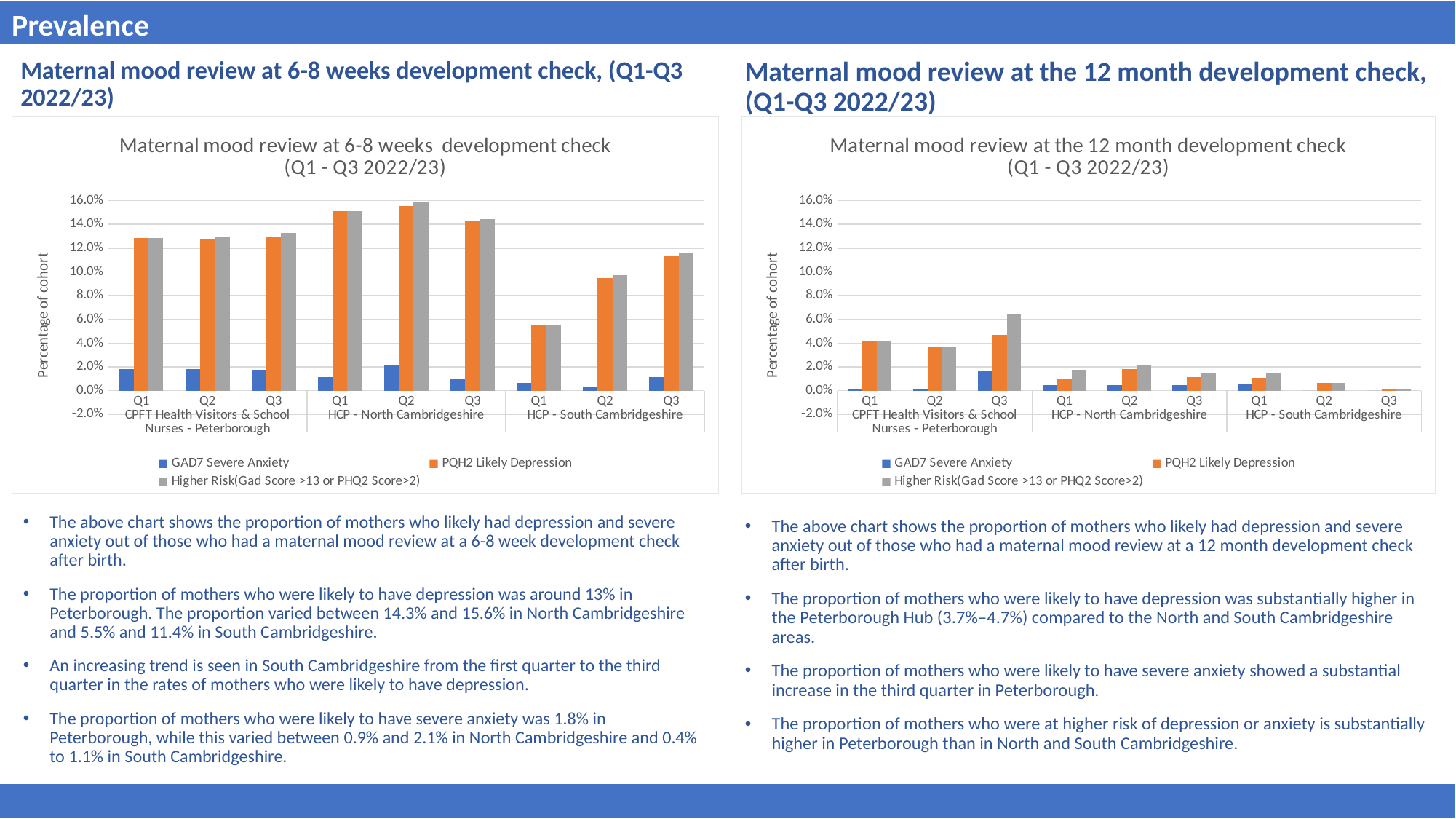
What type of chart is the left chart, 'Maternal mood review at 6-8 weeks development check'? bar chart In the left chart (6-8 weeks), is the PQH2 Likely Depression value for Q1 in CPFT Health Visitors & School Nurses - Peterborough greater or less than 12.0%? greater What is the y-axis label of the right chart (12 month check)? Percentage of cohort In the right chart (12 month check), is the Higher Risk value for Q3 in CPFT Health Visitors & School Nurses - Peterborough greater or less than 4.0%? greater In the left chart (6-8 weeks), which quarter and area has the highest PQH2 Likely Depression value? Q2, HCP - North Cambridgeshire In the left chart (6-8 weeks), does the PQH2 Likely Depression value for HCP - South Cambridgeshire rise or fall from Q1 to Q3? rise How many quarter categories are plotted along the x axis of the right chart (12 month check)? 9 How many series does the legend of the left chart (6-8 weeks) list? 3 In the right chart (12 month check), which is larger: the PQH2 Likely Depression value for Q1 in CPFT Health Visitors & School Nurses - Peterborough or for Q1 in HCP - North Cambridgeshire? Q1 in CPFT Health Visitors & School Nurses - Peterborough In the right chart (12 month check), which quarter and area has the highest Higher Risk value? Q3, CPFT Health Visitors & School Nurses - Peterborough In the left chart (6-8 weeks), which quarter and area has the lowest PQH2 Likely Depression value? Q1, HCP - South Cambridgeshire In the left chart (6-8 weeks), is the PQH2 Likely Depression value for Q1 in HCP - South Cambridgeshire greater or less than 8.0%? less